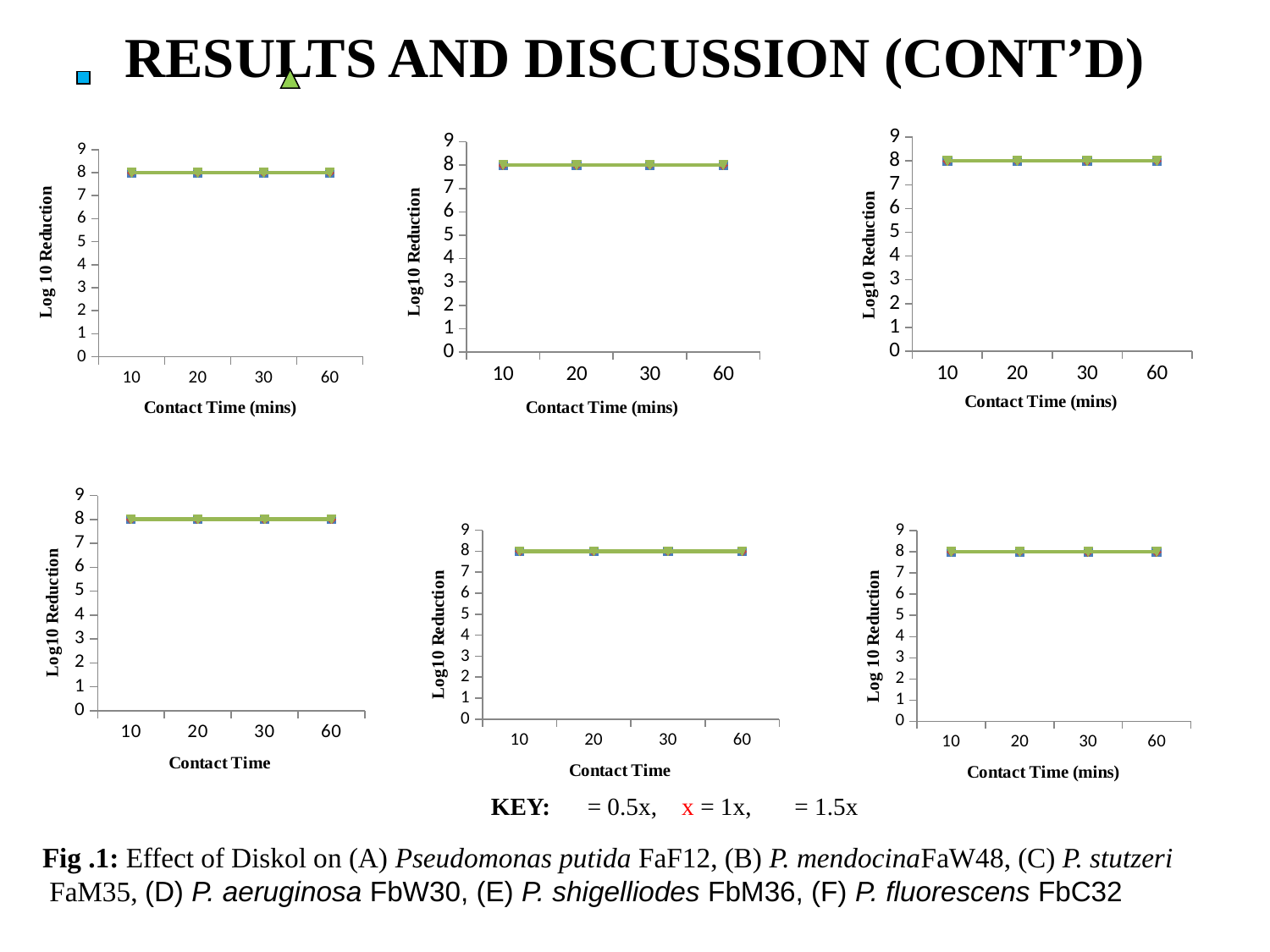
In the top-right chart, what is the difference between the Log10 Reduction at 10 mins and at 60 mins? 0 In the bottom-left chart, what is the Log10 Reduction at a contact time of 60? 8 In the top-middle chart, do the values rise, fall or stay flat as contact time increases from 10 to 60 mins? stay flat In the top-right chart, is the Log10 Reduction at 60 mins greater or less than 5? greater How many charts are shown on the slide? 6 In the top-left chart, how many contact time points are plotted along the x axis? 4 In the bottom-right chart, is the Log 10 Reduction at 30 mins greater or less than 4? greater In the bottom-middle chart, what is the Log10 Reduction at a contact time of 20? 8 In the bottom-left chart, do the values rise, fall or stay flat across the contact times shown? stay flat What is the x-axis title of the top-left chart? Contact Time (mins) In the top-left chart, what is the Log 10 Reduction at a contact time of 10 mins? 8 What kind of chart is the top-left chart? line chart